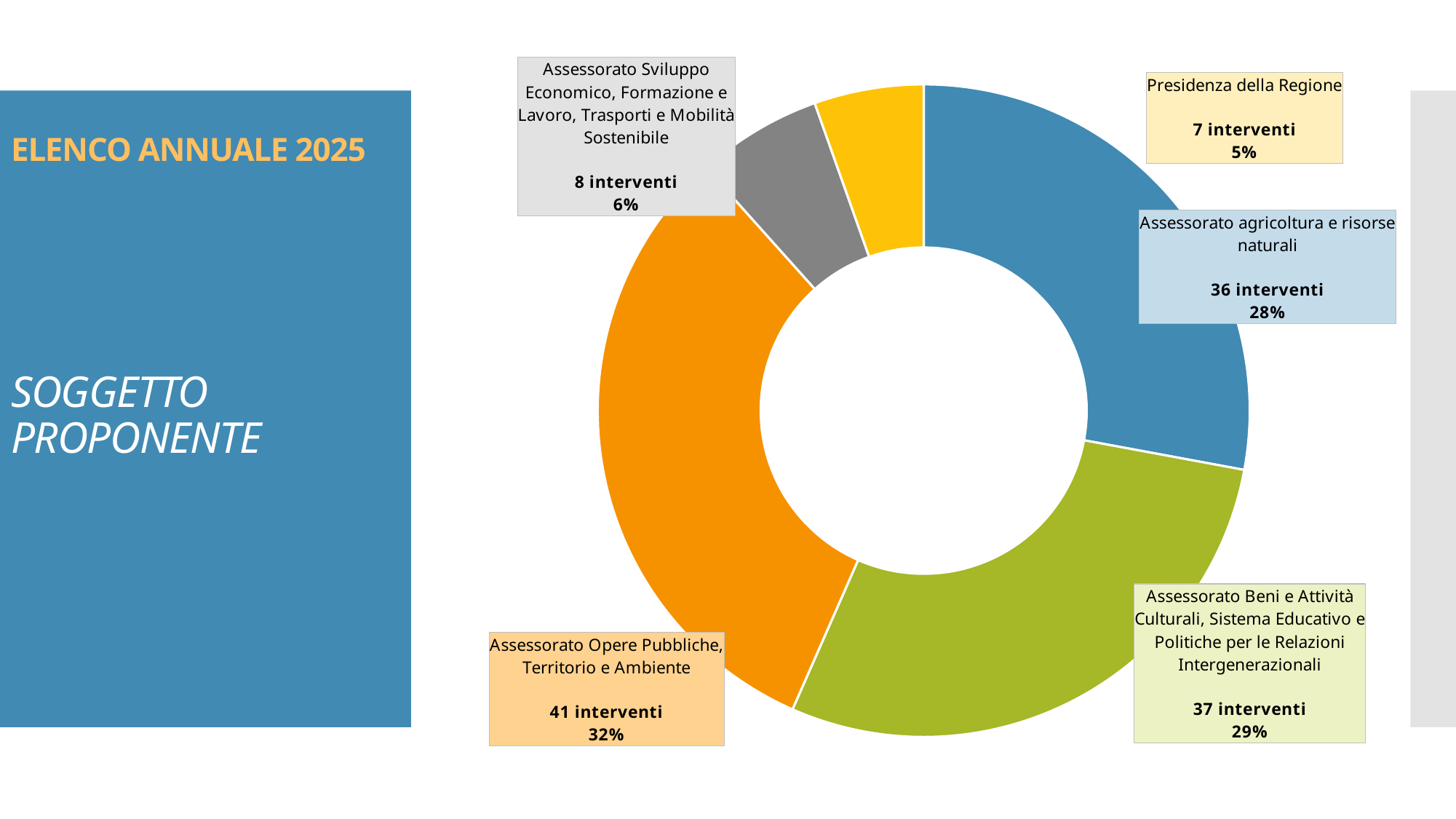
Which soggetto proponente has the highest number of interventi? Assessorato Opere Pubbliche, Territorio e Ambiente How many categories (soggetti proponenti) are shown in the chart? 5 What percentage share does Assessorato Sviluppo Economico, Formazione e Lavoro, Trasporti e Mobilità Sostenibile have? 6% What is the difference in interventi between Assessorato Opere Pubbliche, Territorio e Ambiente and Assessorato agricoltura e risorse naturali? 5 How many interventi are attributed to Assessorato Opere Pubbliche, Territorio e Ambiente? 41 interventi What is the total number of interventi across all categories in the chart? 129 How many interventi are attributed to Assessorato agricoltura e risorse naturali? 36 interventi Which has more interventi: Assessorato Beni e Attività Culturali, Sistema Educativo e Politiche per le Relazioni Intergenerazionali or Assessorato agricoltura e risorse naturali? Assessorato Beni e Attività Culturali, Sistema Educativo e Politiche per le Relazioni Intergenerazionali Which soggetto proponente has the lowest number of interventi? Presidenza della Regione What kind of chart is shown on the slide? Donut (pie) chart What percentage share does Presidenza della Regione have? 5% What colour is the slice for Assessorato Opere Pubbliche, Territorio e Ambiente? Orange